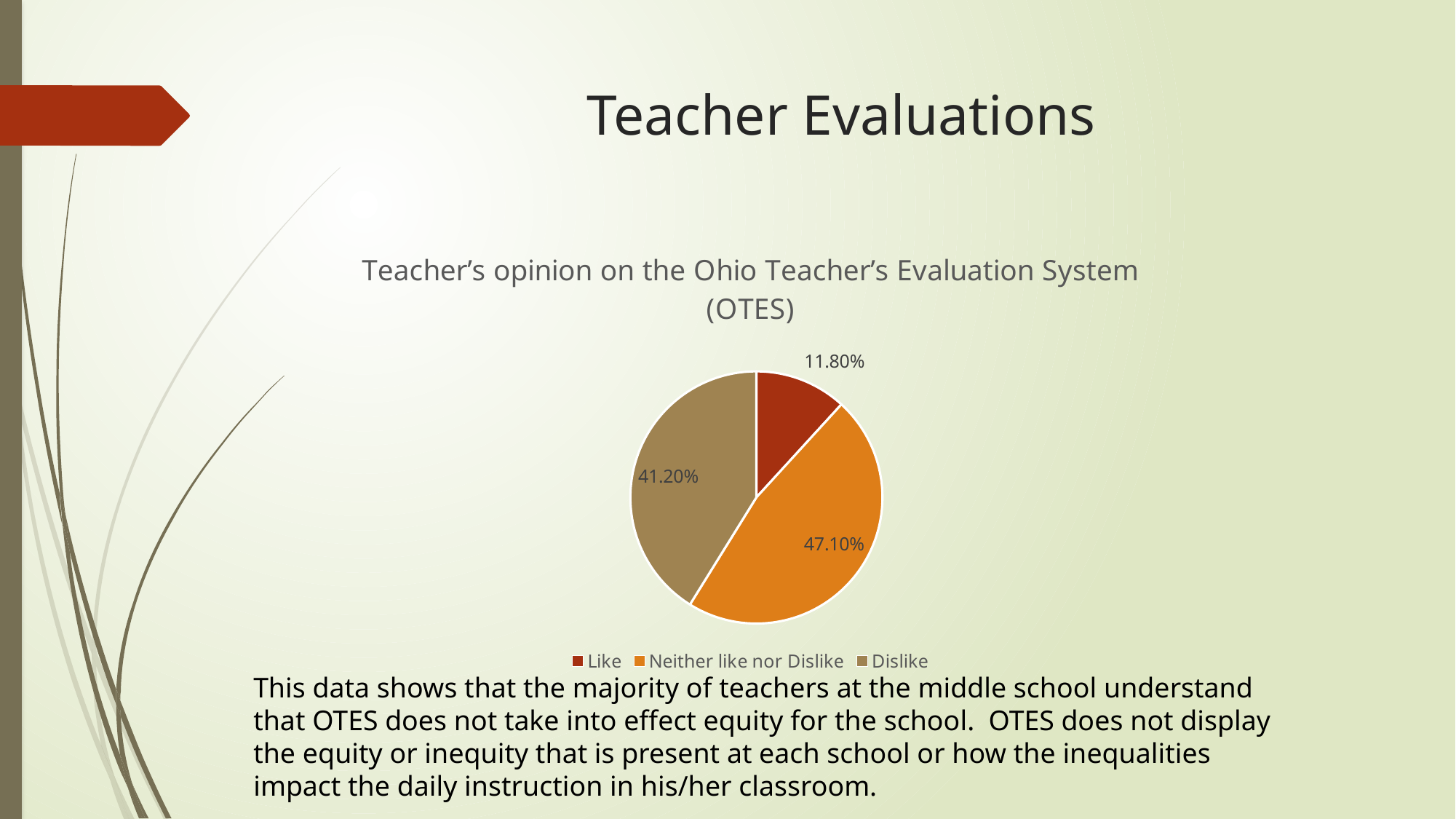
What percentage of teachers answered 'Like'? 11.80% How many categories does the legend list? 3 What type of chart is shown on the slide? Pie chart Which category has the smallest share of the pie? Like What is the title of the chart? Teacher's opinion on the Ohio Teacher's Evaluation System (OTES) Which is larger, the share for 'Dislike' or the share for 'Like'? Dislike How many slices does the pie chart have? 3 What percentage of teachers answered 'Dislike'? 41.20% Which category has the largest share of the pie? Neither like nor Dislike What percentage of teachers answered 'Neither like nor Dislike'? 47.10% What is the difference between the 'Neither like nor Dislike' share and the 'Dislike' share? 5.90% What colour is the 'Like' slice in the pie chart? Dark red